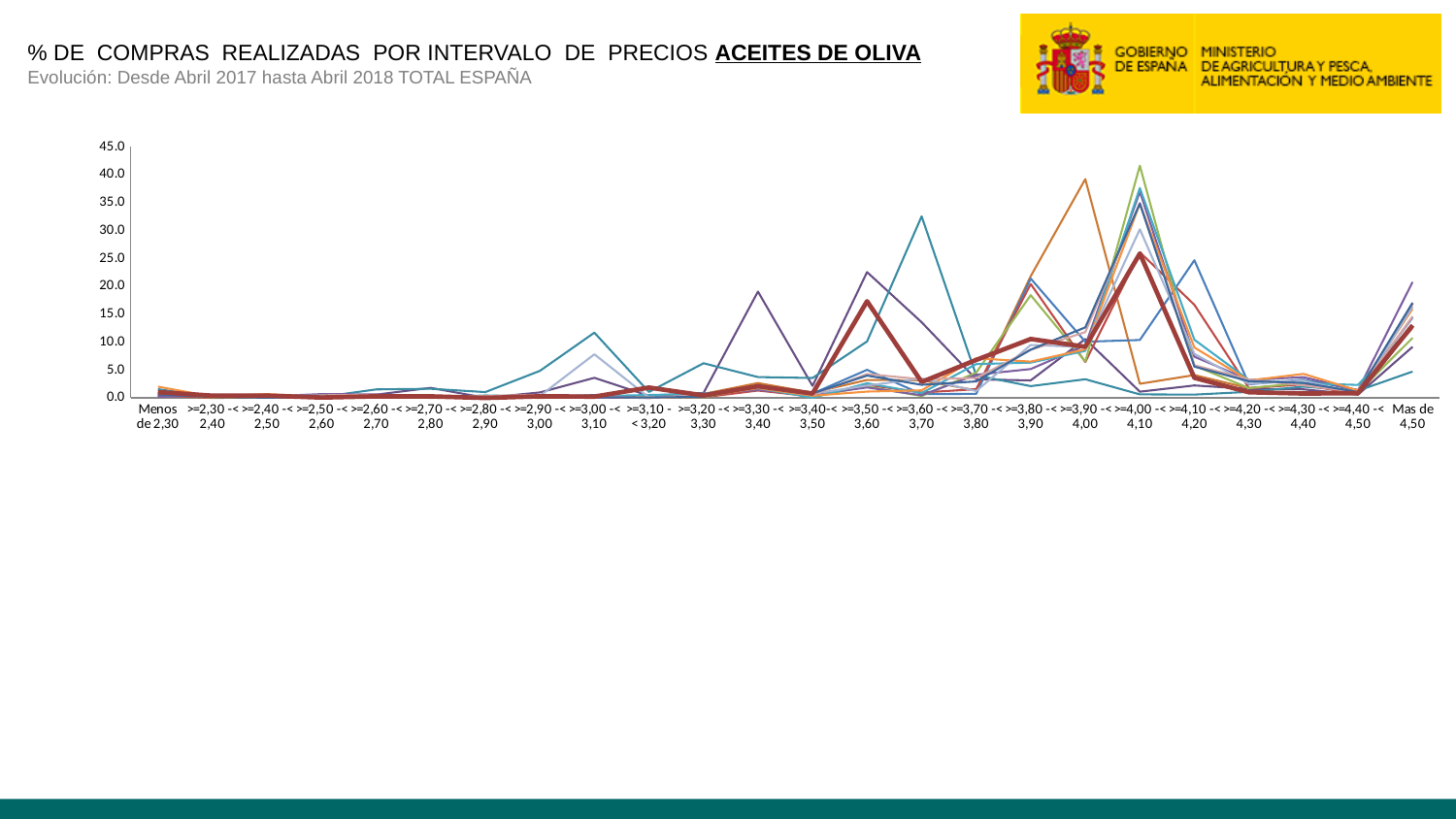
Is the value of the thick dark red line at >=3,60 -< 3,70 greater or less than 10? less How many price-interval categories are shown on the x axis? 24 Is the highest point of any line at >=3,60 -< 3,70 greater or less than 25? greater Is the value of the thick dark red line at >=3,50 -< 3,60 greater or less than 10? greater Does the thick dark red line rise or fall from >=3,50 -< 3,60 to >=3,60 -< 3,70? fall What is the first category on the x axis? Menos de 2,30 Does the thick dark red line rise or fall from >=3,90 -< 4,00 to >=4,00 -< 4,10? rise What is the highest value shown on the y axis? 45.0 What kind of chart is shown on the slide? line chart